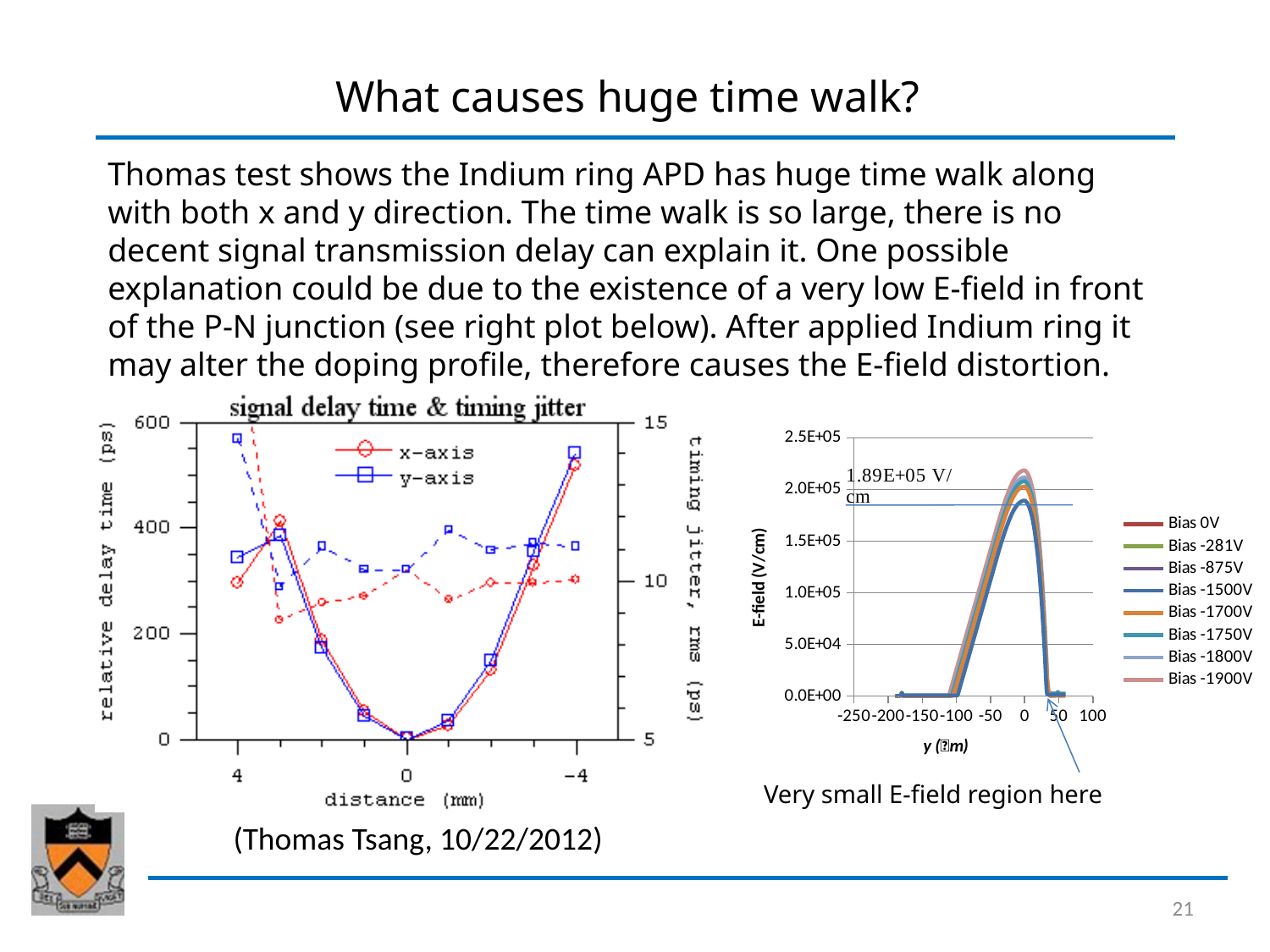
In the left chart, how does the relative delay time change as distance goes from 4 mm to 0 mm? it falls In the left chart, is the relative delay time for the x-axis series at distance 4 mm greater or less than 400 ps? less What kind of chart is the chart on the right? line chart How many series does the legend of the right chart list? 8 What is the title of the chart on the left? signal delay time & timing jitter What kind of chart is the chart on the left? line chart What is the label of the vertical axis of the right chart? E-field (V/cm) In the left chart, is the relative delay time for the y-axis series at distance -4 mm greater or less than 400 ps? greater In the left chart, at which distance (mm) is the relative delay time lowest? 0 In the right chart, is the peak E-field of the Bias -1900V series greater or less than 1.5E+05 V/cm? greater In the right chart, which bias series reaches the highest peak E-field? Bias -1900V How many series does the legend of the left chart list? 2